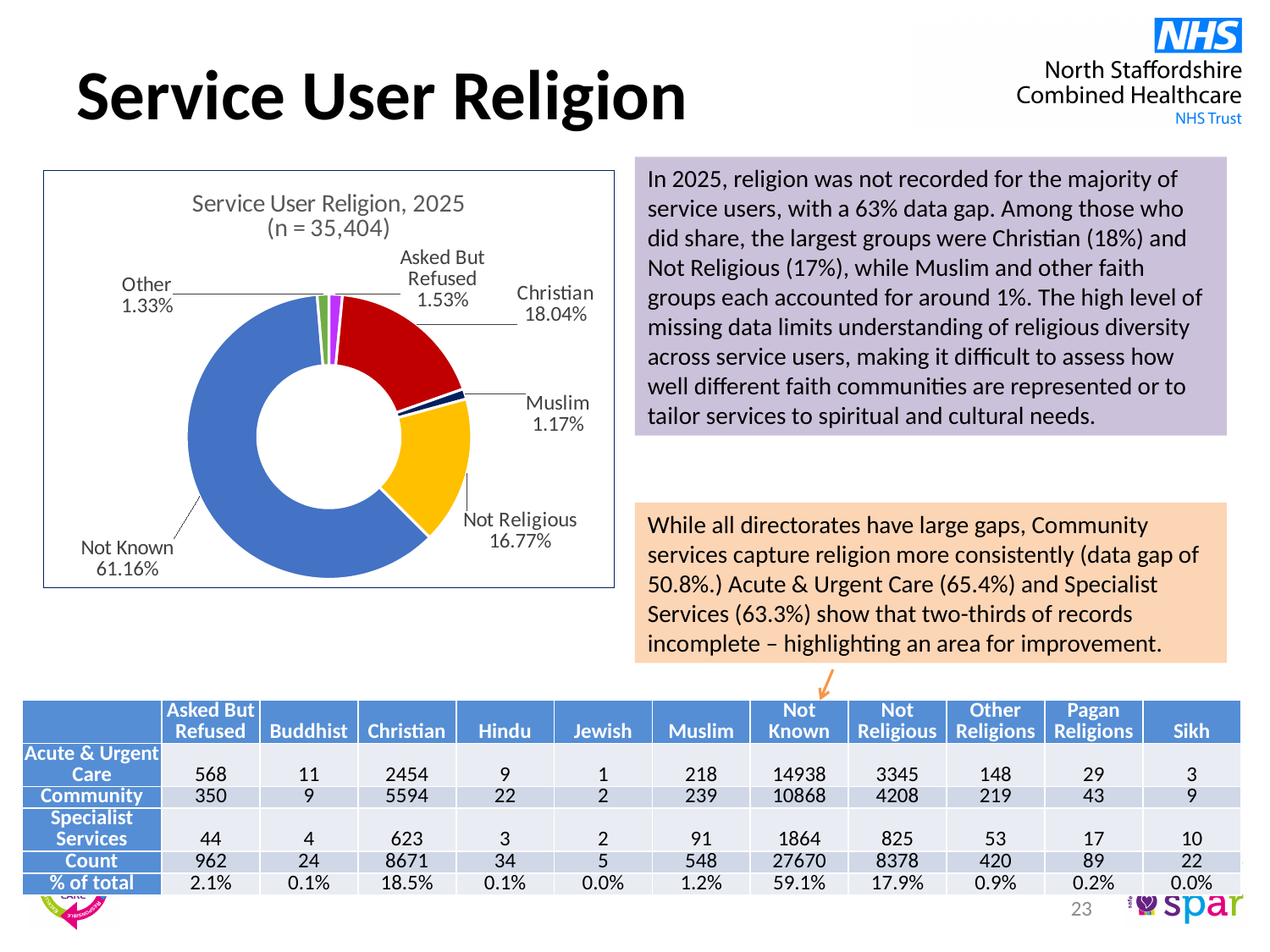
What percentage is labelled for Asked But Refused in the Service User Religion, 2025 chart? 1.53% What type of chart is used to show Service User Religion, 2025? Doughnut (pie) chart Which labelled category has the smallest slice in the Service User Religion, 2025 chart? Muslim In the Service User Religion, 2025 chart, which is larger: the Other slice or the Asked But Refused slice? Asked But Refused What percentage of service users in the Service User Religion, 2025 chart are recorded as Not Known? 61.16% What sample size (n) is stated in the title of the Service User Religion, 2025 chart? 35,404 Which category has the largest slice in the Service User Religion, 2025 chart? Not Known How many labelled categories are shown in the Service User Religion, 2025 chart? 6 What is the percentage shown for Muslim in the Service User Religion, 2025 chart? 1.17% What share of the Service User Religion, 2025 chart is Christian? 18.04% What percentage does the Not Religious slice represent in the Service User Religion, 2025 chart? 16.77% In the Service User Religion, 2025 chart, how many percentage points larger is the Christian share than the Not Religious share? 1.27 percentage points